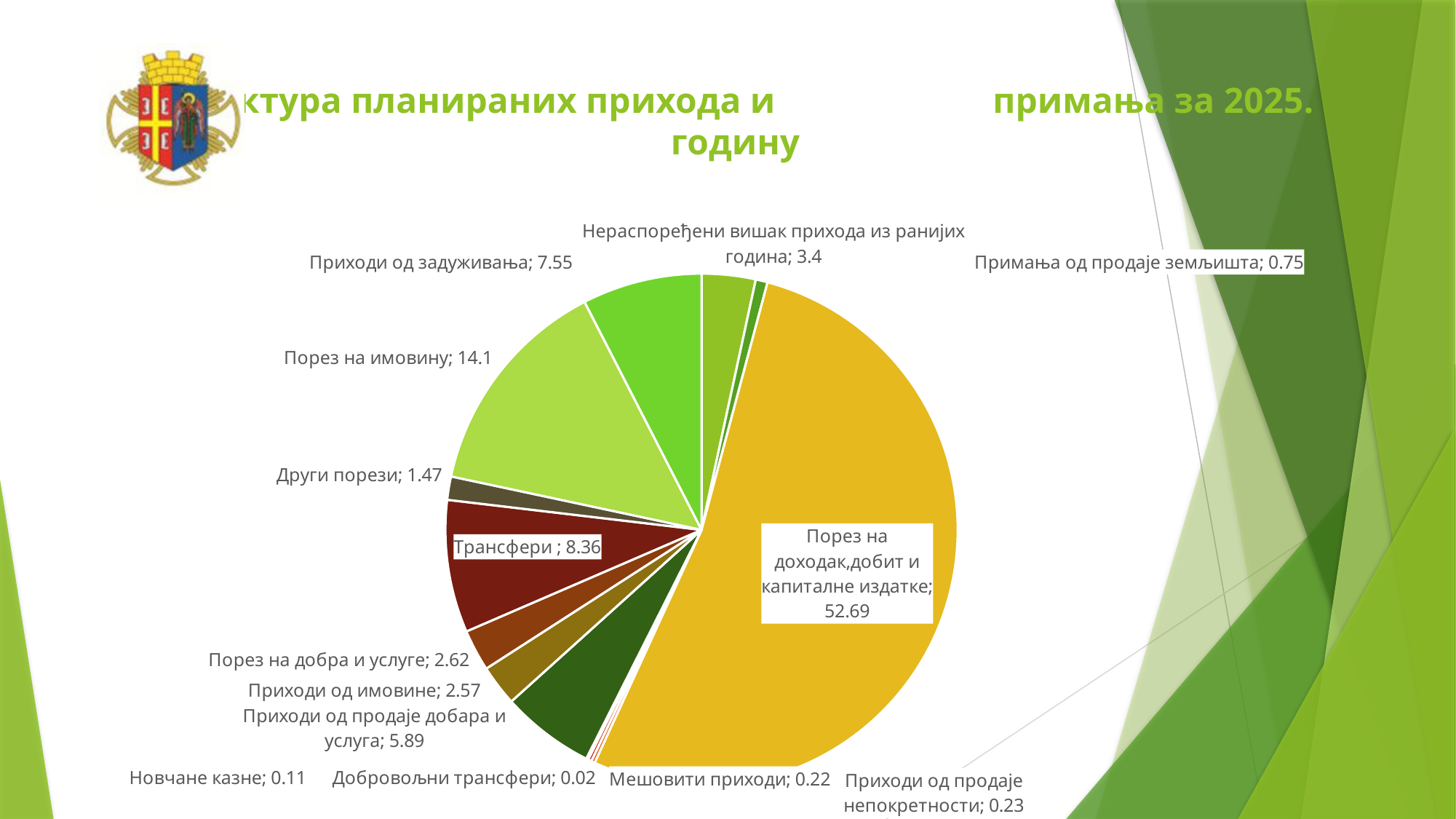
What is the difference between the values for Приходи од задуживања and Нераспоређени вишак прихода из ранијих година? 4.15 What is the value for Приходи од задуживања? 7.55 What is the value for Трансфери? 8.36 Which is larger, Приходи од продаје добара и услуга or Порез на добра и услуге? Приходи од продаје добара и услуга What is the value for Порез на имовину? 14.1 What is the value for Нераспоређени вишак прихода из ранијих година? 3.4 What is the value for Порез на доходак,добит и капиталне издатке? 52.69 How many categories are shown in the pie chart? 14 What kind of chart is shown on the slide? pie chart Which category has the smallest value in the pie chart? Добровољни трансфери What is the difference between the values for Порез на имовину and Трансфери? 5.74 Which category has the largest slice of the pie? Порез на доходак,добит и капиталне издатке